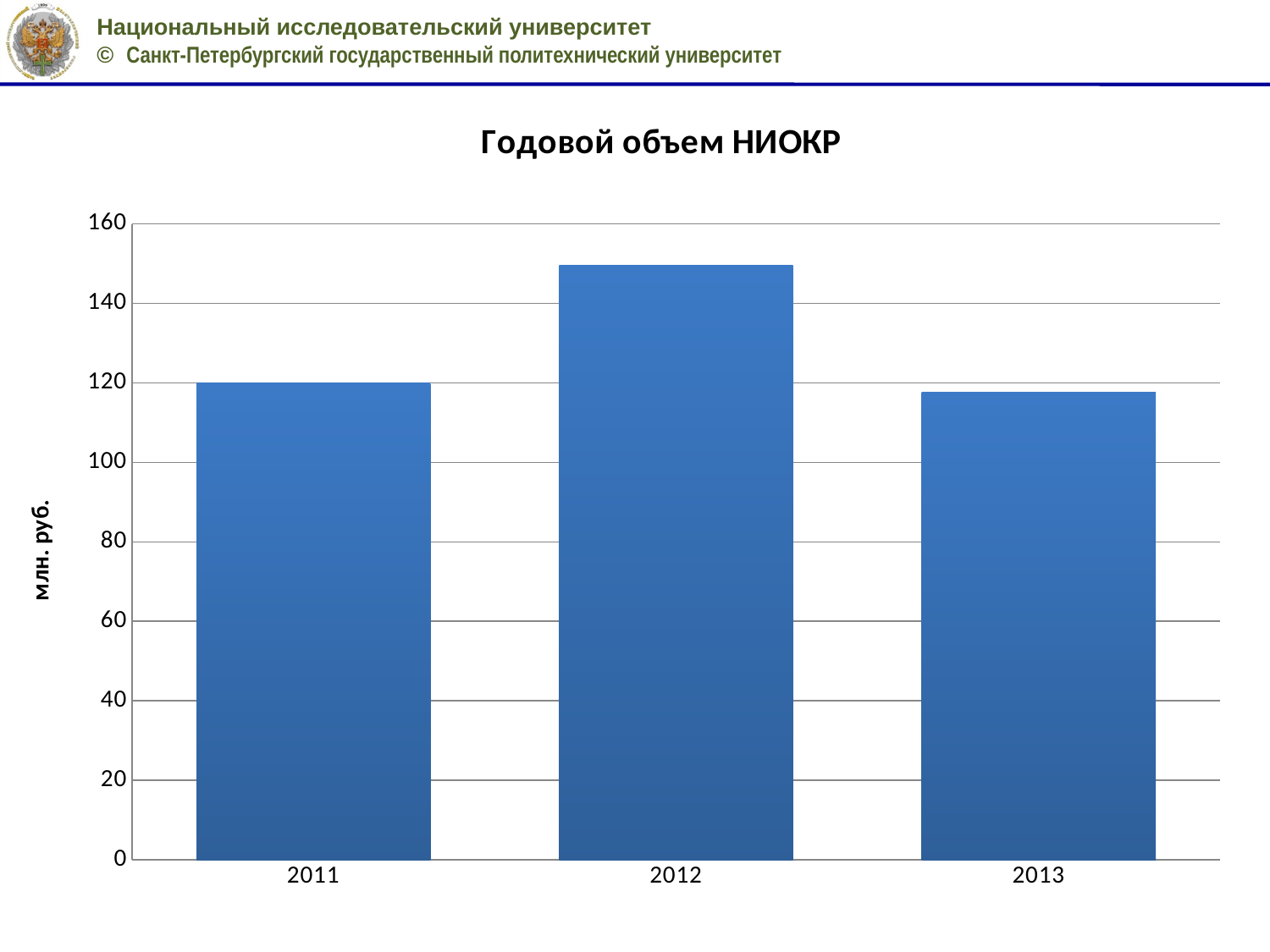
Is the value for 2012 greater or less than 160? less What kind of chart is shown on the slide? bar chart What is the label on the vertical axis of the chart? млн. руб. Which year has the highest value in the chart? 2012 Does the value rise or fall from 2012 to 2013? fall Is the value for 2013 greater or less than 120? less Is the value for 2013 greater or less than 100? greater What is the title of the chart? Годовой объем НИОКР How many years are shown on the x axis of the chart? 3 Which is larger, the value for 2012 or the value for 2013? 2012